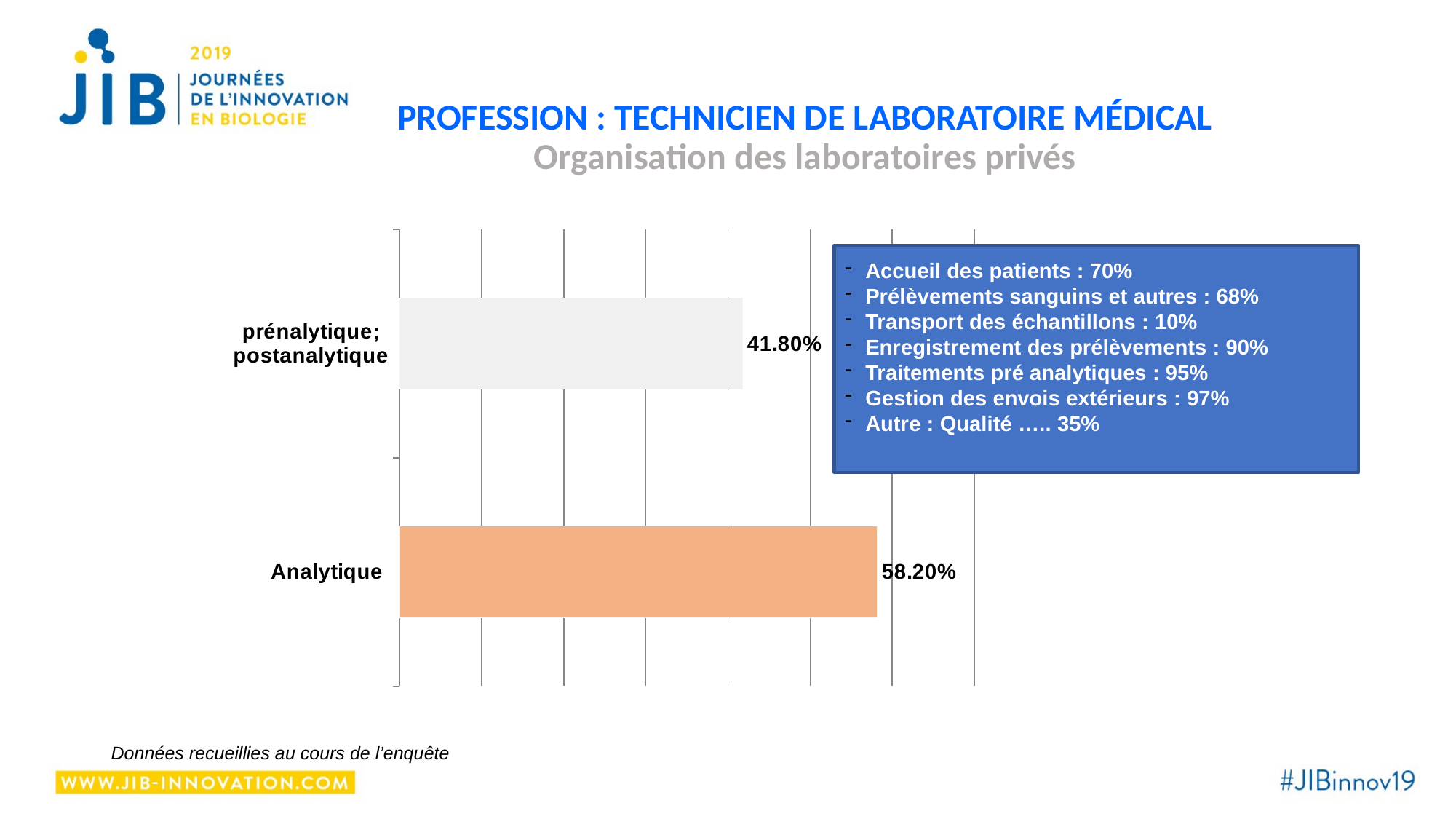
Are the bars in the chart horizontal or vertical? horizontal Which category has the highest value? Analytique How many categories are shown in the chart? 2 What is the difference between the values for Analytique and prénalytique; postanalytique? 16.40% What kind of chart is shown on the slide? bar chart What is the total of the two values shown in the chart? 100.00% What is the value for Analytique? 58.20% What colour is the bar for Analytique? orange Which is larger, the value for Analytique or the value for prénalytique; postanalytique? Analytique Which category has the lowest value? prénalytique; postanalytique What is the value for prénalytique; postanalytique? 41.80%